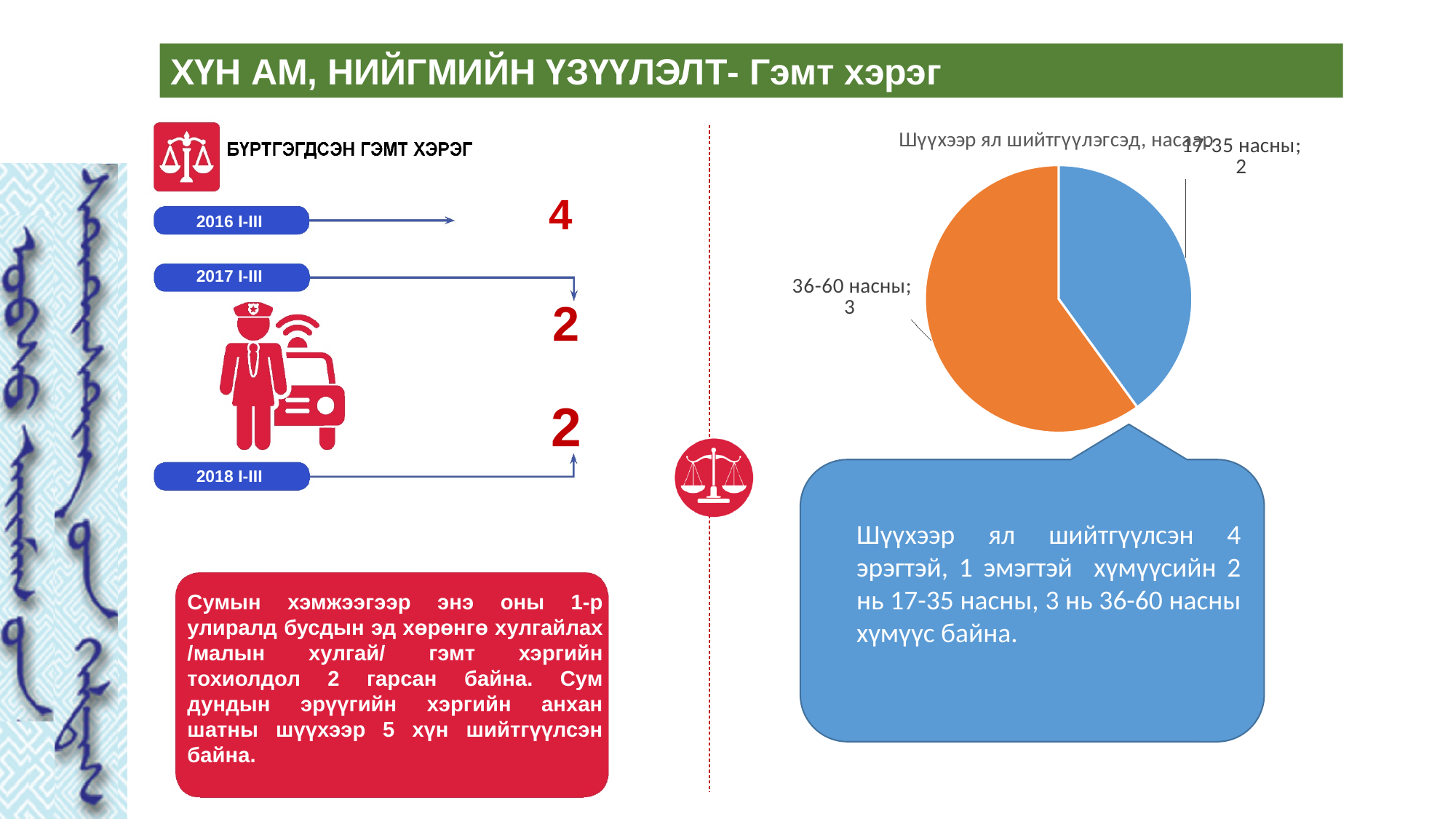
What is the title of the pie chart? Шүүхээр ял шийтгүүлэгсэд, насаар In the pie chart, which is larger: 17-35 насны or 36-60 насны? 36-60 насны In the pie chart, what is the value for the 36-60 насны slice? 3 How many slices does the pie chart have? 2 What colour is the 36-60 насны slice in the pie chart? orange What type of chart is shown on the right side of the slide? pie chart Which slice of the pie chart is the largest? 36-60 насны Which slice of the pie chart is the smallest? 17-35 насны What is the total of all slices in the pie chart? 5 In the pie chart, what is the value for the 17-35 насны slice? 2 What is the difference between the 36-60 насны and 17-35 насны values in the pie chart? 1 What share of the pie chart does the 36-60 насны slice represent? 60%